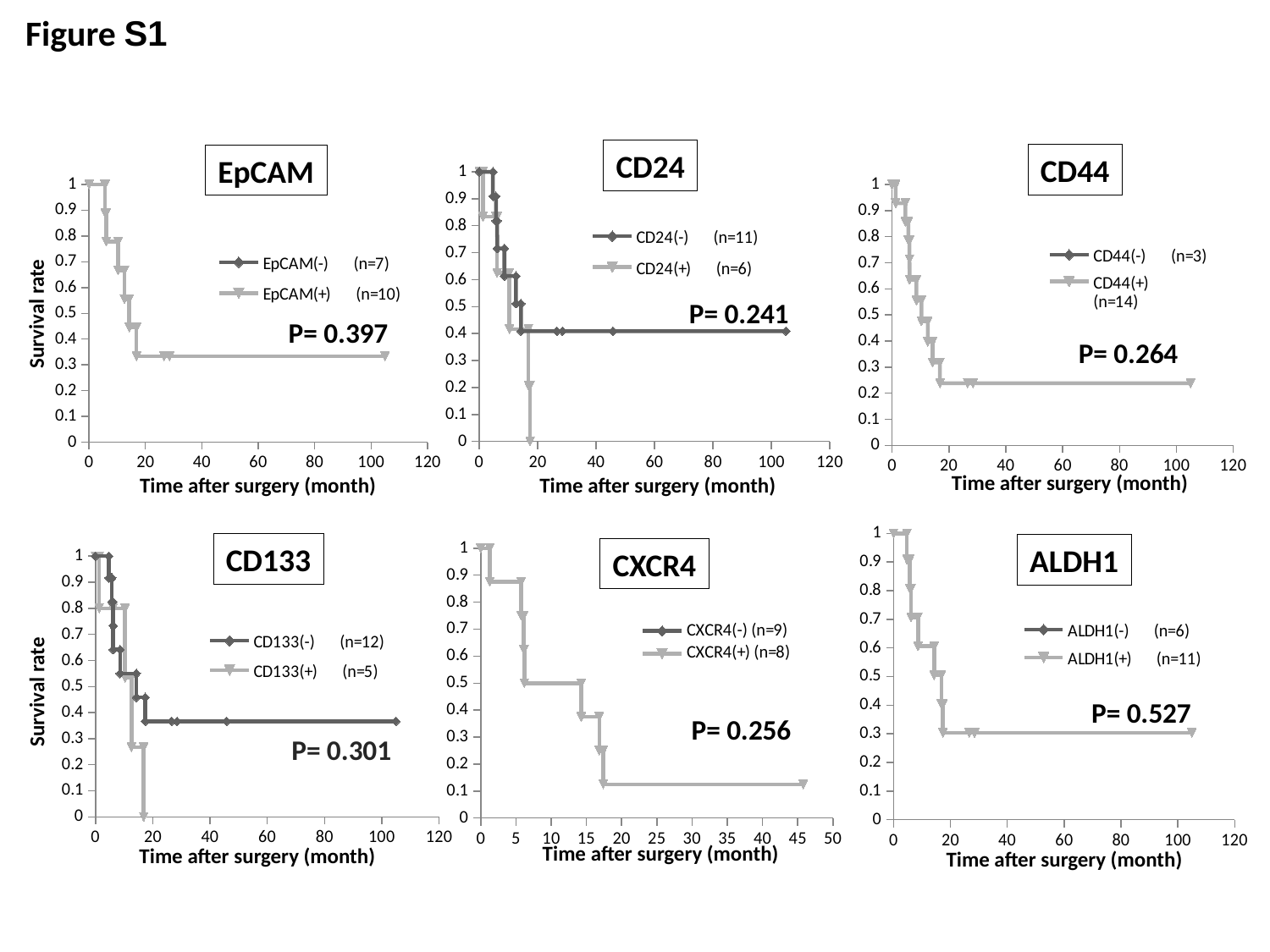
How many charts are shown on the slide? 6 In the CD24 chart, which series has the higher survival rate at 40 months, CD24(-) or CD24(+)? CD24(-) In the EpCAM chart, does the survival rate for EpCAM(+) rise or fall as time after surgery increases? fall What kind of chart is the EpCAM chart? line chart What P value is printed on the CXCR4 chart? P= 0.256 In the ALDH1 chart, is the survival rate for ALDH1(+) at 100 months greater or less than 0.5? less In the CXCR4 chart, is the survival rate for CXCR4(+) at 45 months greater or less than 0.2? less In the CD24 chart, how many series does the legend list? 2 In the CD44 chart, is the survival rate for CD44(+) at 100 months greater or less than 0.3? less In the CD44 chart, what is the sample size (n) given in the legend for CD44(+)? n=14 In the CD133 chart, which series has the higher survival rate at 40 months, CD133(-) or CD133(+)? CD133(-)